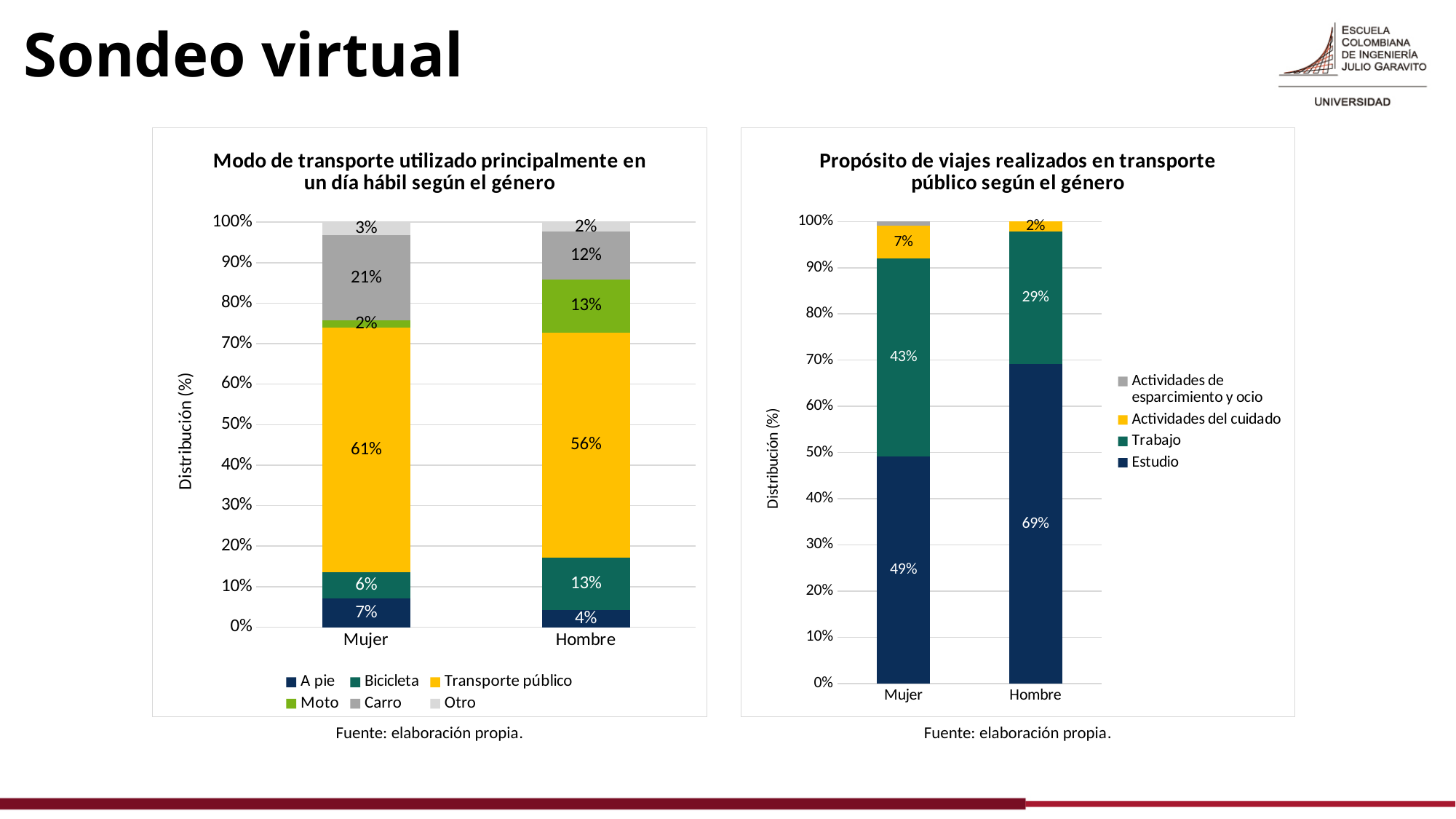
In the chart 'Modo de transporte utilizado principalmente en un día hábil según el género', which is larger: Bicicleta for Mujer or Bicicleta for Hombre? Bicicleta for Hombre In the chart 'Propósito de viajes realizados en transporte público según el género', which colour represents Estudio in the legend? Dark blue In the chart 'Propósito de viajes realizados en transporte público según el género', what is the value for Trabajo for Mujer? 43% What type of chart is 'Propósito de viajes realizados en transporte público según el género'? Stacked bar chart How many series does the legend of the chart 'Modo de transporte utilizado principalmente en un día hábil según el género' list? 6 In the chart 'Modo de transporte utilizado principalmente en un día hábil según el género', what is the value for Transporte público for Mujer? 61% In the chart 'Propósito de viajes realizados en transporte público según el género', what is the difference between the Estudio values for Hombre and Mujer? 20% In the chart 'Modo de transporte utilizado principalmente en un día hábil según el género', what is the value for Carro for Hombre? 12% In the chart 'Propósito de viajes realizados en transporte público según el género', how many categories are shown on the x axis? 2 In the chart 'Propósito de viajes realizados en transporte público según el género', what is the value for Estudio for Hombre? 69% In the chart 'Modo de transporte utilizado principalmente en un día hábil según el género', what is the difference between the Carro values for Mujer and Hombre? 9% In the chart 'Modo de transporte utilizado principalmente en un día hábil según el género', which mode has the largest share for Hombre? Transporte público